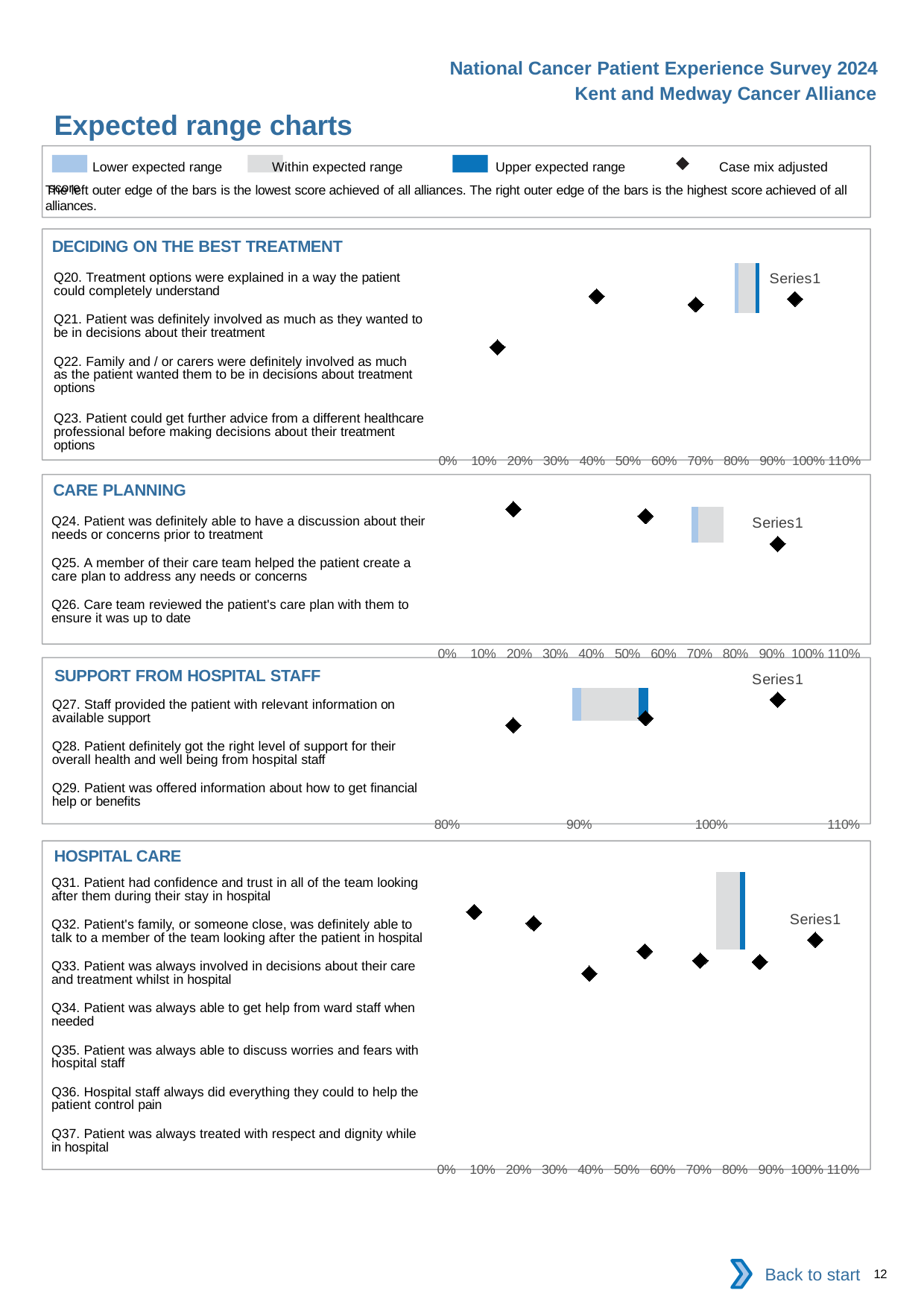
On the SUPPORT FROM HOSPITAL STAFF chart, what is the lowest value shown on the x axis? 80% On the CARE PLANNING chart, how many diamond markers are plotted? 3 What series name is shown as a label on each of the four charts? Series1 How many charts are shown on the slide? 4 On the DECIDING ON THE BEST TREATMENT chart, how many diamond markers are plotted? 4 What does the diamond marker in the legend represent? Case mix adjusted score How many entries does the legend at the top of the slide list? 4 On the HOSPITAL CARE chart, is the leftmost diamond marker greater or less than 20%? less On the CARE PLANNING chart, is the rightmost diamond marker greater or less than 80%? greater On the DECIDING ON THE BEST TREATMENT chart, is the leftmost diamond marker greater or less than 20%? less